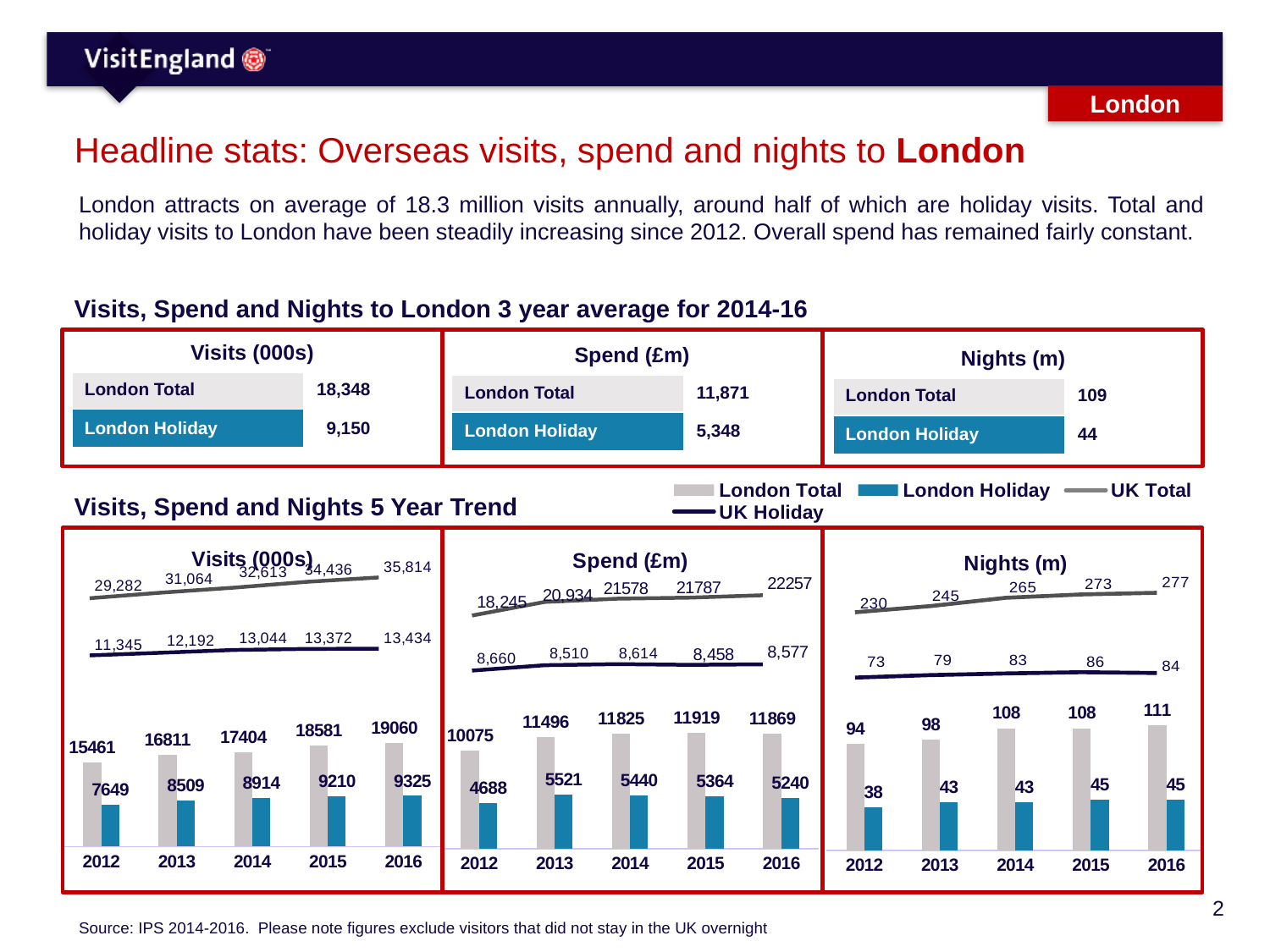
In the Spend (£m) trend chart, which year has the larger London Holiday value, 2014 or 2016? 2014 What kind of chart is used to show the London Total and London Holiday values in the 5 Year Trend section? Bar chart How many years are shown on the x axis of the Spend (£m) trend chart? 5 In the Visits (000s) trend chart, what is the difference between London Total and London Holiday in 2016? 9735 In the Visits (000s) trend chart, what is the London Total value for 2014? 17404 In the Nights (m) trend chart, what is the UK Total value for 2016? 277 In the Visits (000s) trend chart, do the London Total values rise or fall from 2012 to 2016? Rise In the Nights (m) trend chart, what is the difference between the UK Holiday values for 2015 and 2016? 2 How many series does the legend above the 5 Year Trend charts list? 4 In the Nights (m) trend chart, which year has the lowest London Holiday value? 2012 In the Visits (000s) trend chart, which year has the highest London Holiday value? 2016 In the Spend (£m) trend chart, what is the London Holiday value for 2013? 5521